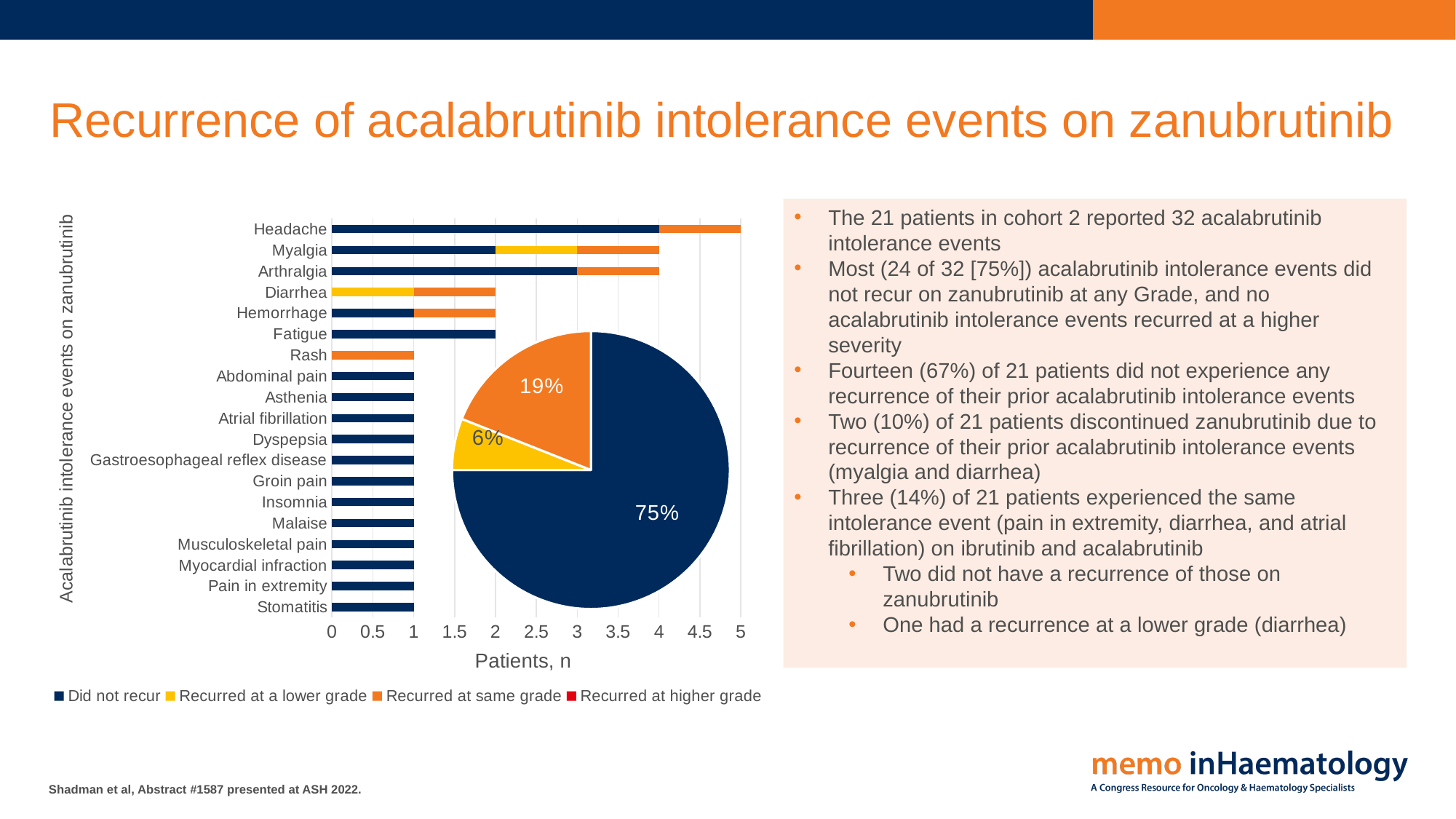
What is the x-axis title of the bar chart? Patients, n In the bar chart, how many intolerance event categories are listed on the y axis? 19 In the bar chart, is the total number of patients for Headache greater or less than 4? greater In the bar chart, which has more total patients, Arthralgia or Diarrhea? Arthralgia In the pie chart, what is the share of the smallest slice? 6% How many series does the legend of the bar chart list? 4 In the bar chart, what is the total number of patients for Headache? 5 In the bar chart, what is the total number of patients for Myalgia? 4 In the bar chart, which intolerance event has the highest total number of patients? Headache What kind of chart is the chart on the left showing acalabrutinib intolerance events by patient count? Bar chart In the bar chart, how many patients with Fatigue did not recur? 2 In the pie chart, what share of events did not recur (the largest slice)? 75%